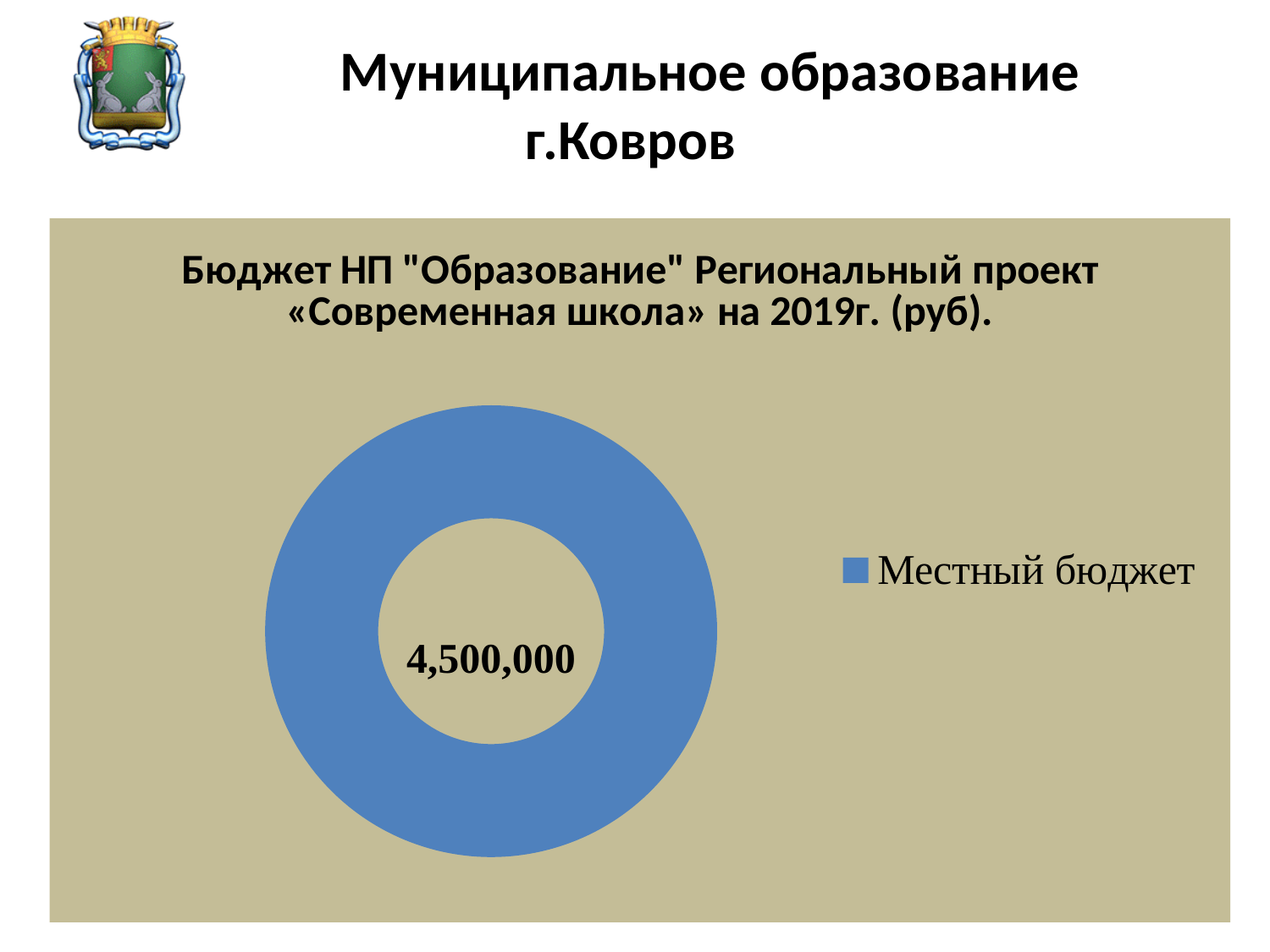
What is the value for Местный бюджет? 4,500,000 What is the total of all values shown in the chart? 4,500,000 What kind of chart is shown on the slide? doughnut chart What share of the chart does Местный бюджет represent? 100% What is the title of the chart? Бюджет НП "Образование" Региональный проект «Современная школа» на 2019г. (руб). What is the legend entry shown on the chart? Местный бюджет How many categories does the chart show? 1 How many entries does the legend list? 1